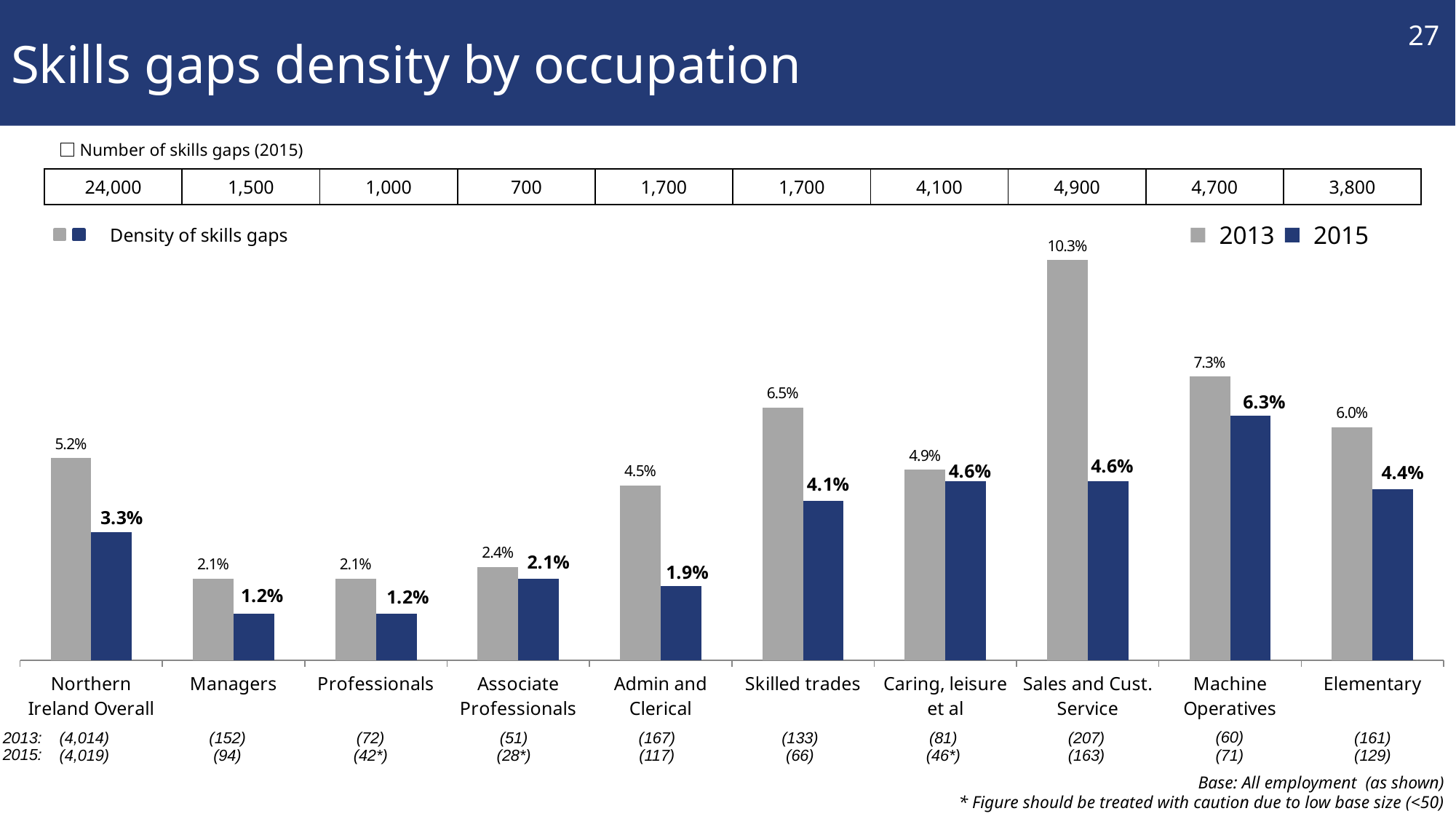
Which occupation has the highest 2015 density of skills gaps? Machine Operatives What is the difference between the 2013 and 2015 density of skills gaps for Sales and Cust. Service? 5.7% Which is larger for Skilled trades: the 2013 density or the 2015 density of skills gaps? 2013 What is the 2015 density of skills gaps for Machine Operatives? 6.3% How many occupation categories are shown on the chart? 10 Which colour represents the 2015 series in the chart? Dark blue Which occupation has the highest 2013 density of skills gaps? Sales and Cust. Service What kind of chart is shown on the slide? Bar chart What is the 2015 density of skills gaps for Northern Ireland Overall? 3.3% How many series does the legend list? 2 What is the number of skills gaps (2015) for Sales and Cust. Service? 4,900 What is the 2013 density of skills gaps for Sales and Cust. Service? 10.3%